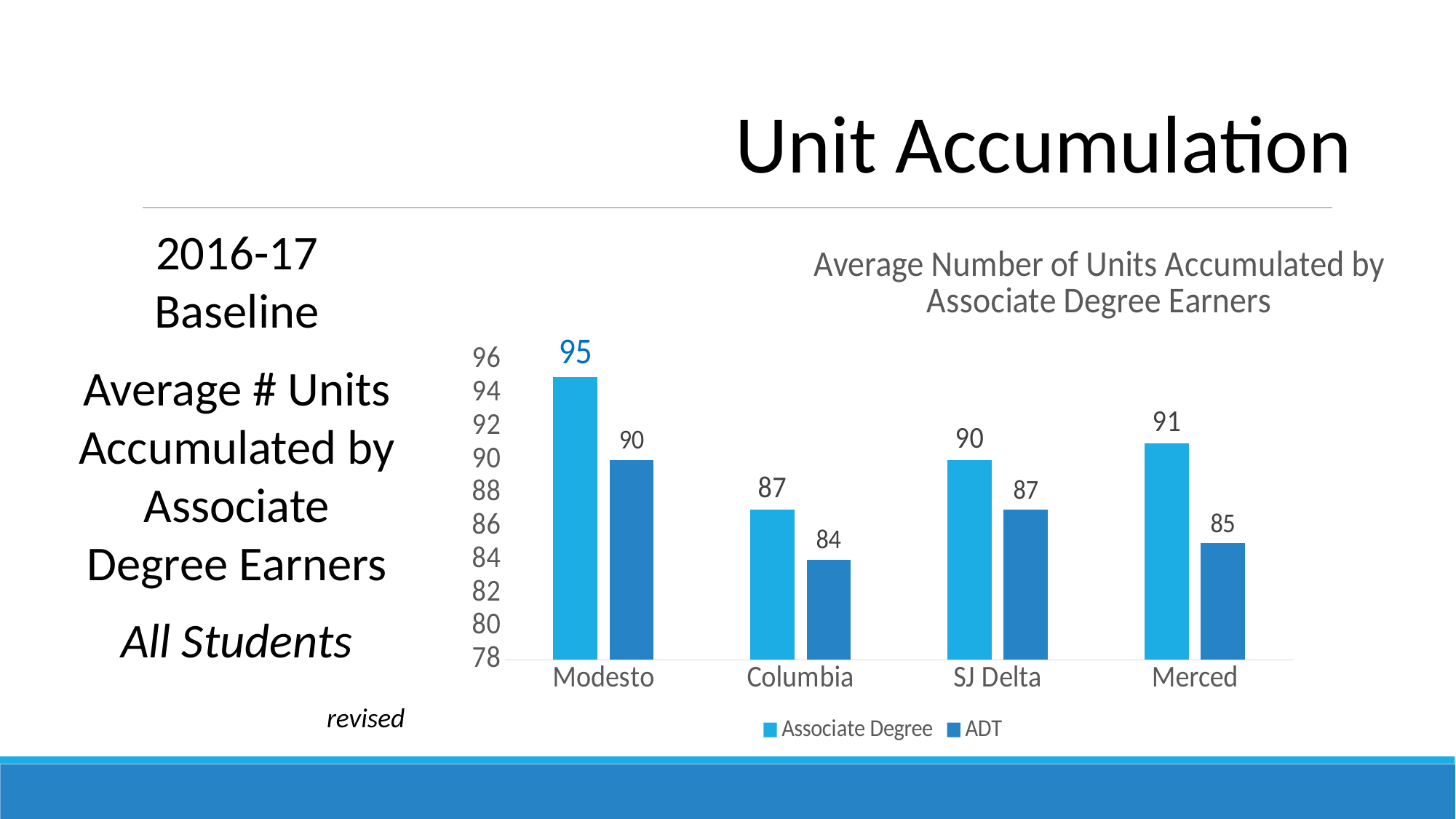
What is the Associate Degree value for Modesto? 95 Which college has the highest Associate Degree value? Modesto What kind of chart is shown? Bar chart What is the ADT value for Columbia? 84 What is the ADT value for Merced? 85 Which college has the lowest ADT value? Columbia How many series does the legend list? 2 What is the difference between the Associate Degree and ADT values for Merced? 6 What is the title of the chart? Average Number of Units Accumulated by Associate Degree Earners Which is larger, the ADT value for Modesto or the ADT value for SJ Delta? Modesto What is the difference between the Associate Degree values for Modesto and Columbia? 8 How many colleges are shown on the x axis? 4